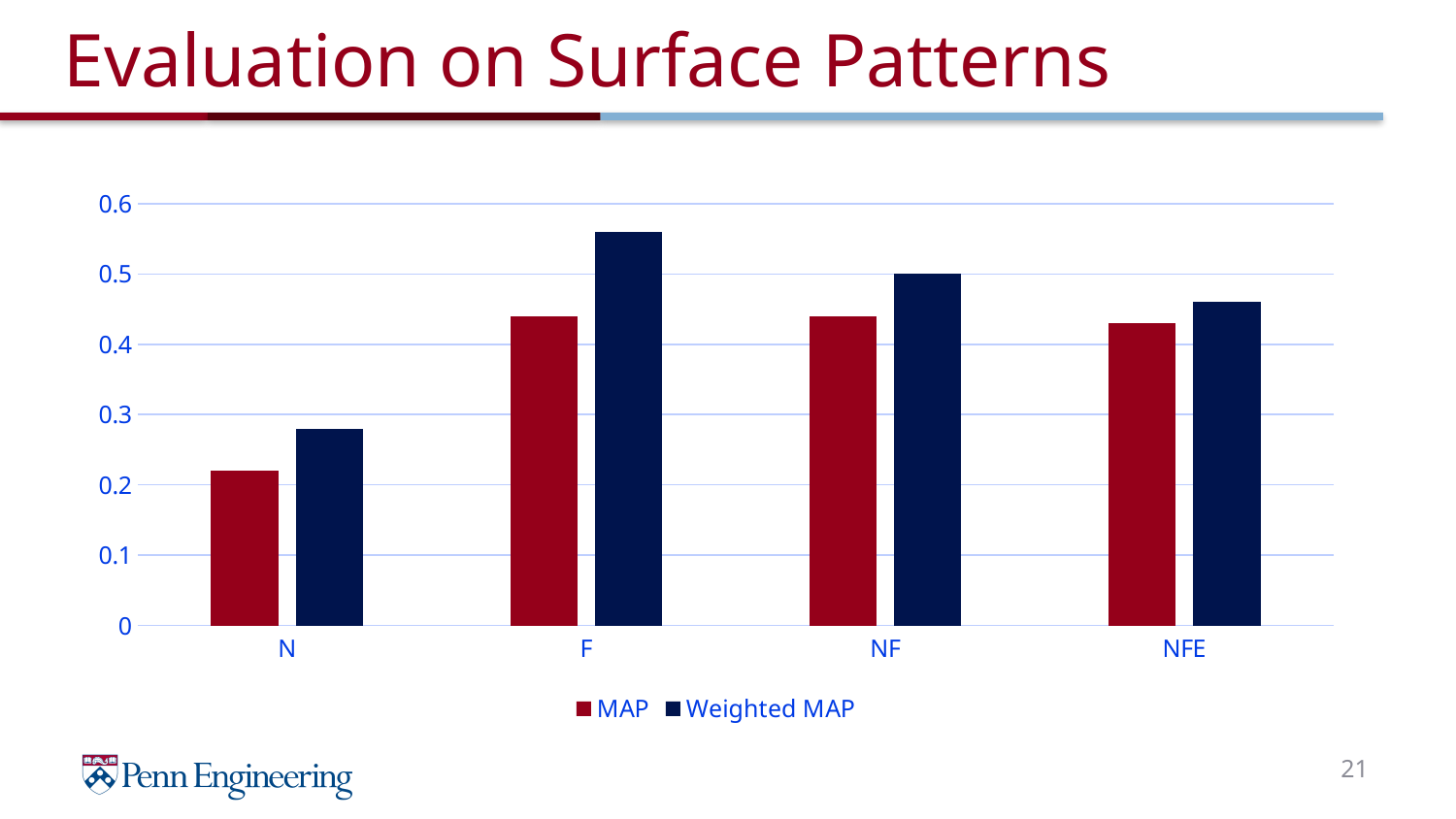
Is the MAP value for N greater or less than 0.3? less How many categories are shown on the x axis? 4 Which series is shown in dark blue in the legend? Weighted MAP Which category has the highest Weighted MAP value? F Is the Weighted MAP value for F greater or less than 0.5? greater How many series does the legend list? 2 For category F, which is larger: MAP or Weighted MAP? Weighted MAP Which category has the lowest MAP value? N Which category has the lowest Weighted MAP value? N What is the title of the slide containing the chart? Evaluation on Surface Patterns Is the MAP value for NFE greater or less than 0.4? greater What kind of chart is shown on the slide? bar chart